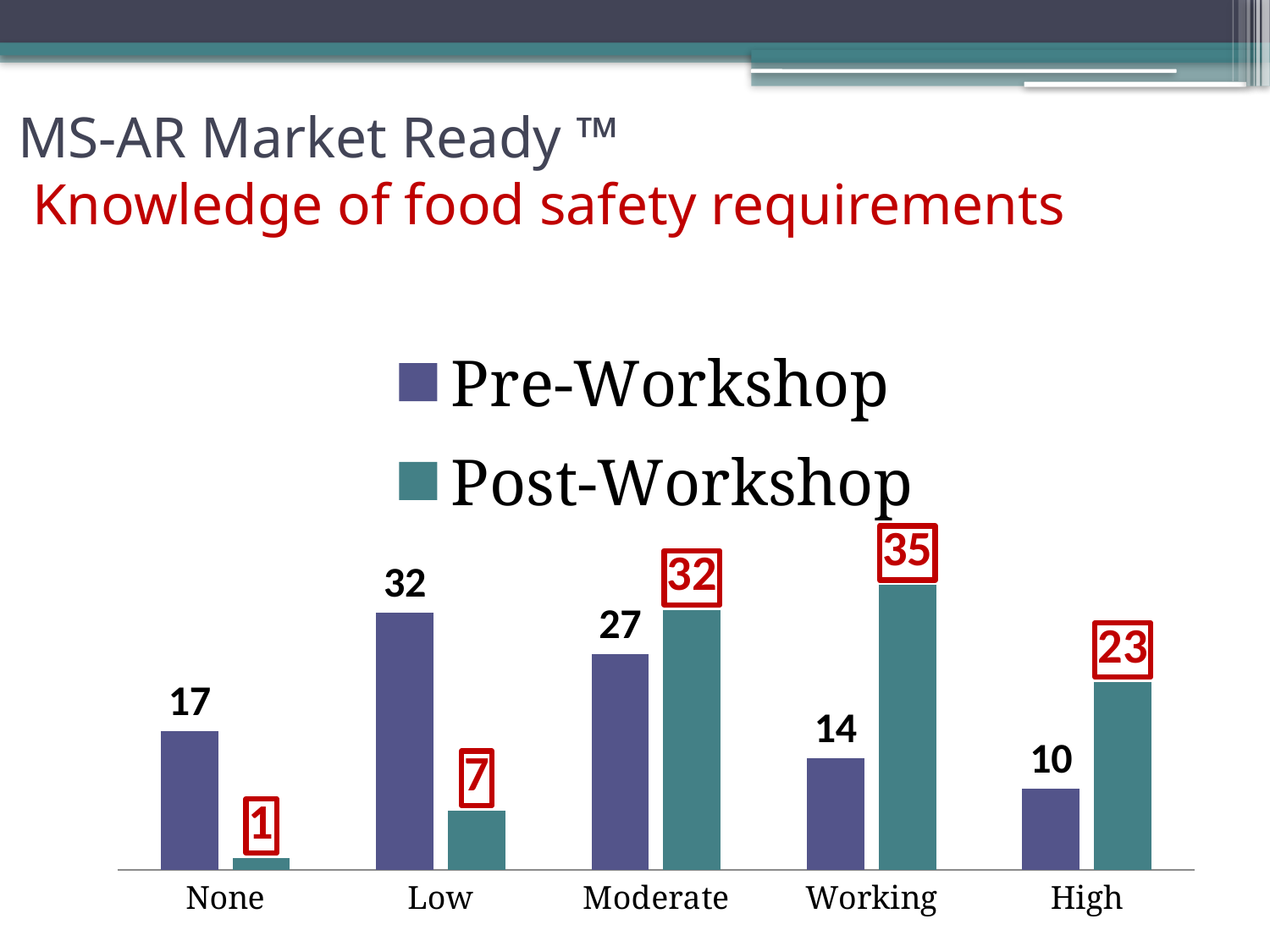
Which category has the lowest Pre-Workshop value? High Which series is shown in teal in the legend? Post-Workshop What is the Post-Workshop value for the None category? 1 What is the Post-Workshop value for the Working category? 35 How many series does the legend list? 2 What kind of chart is shown on the slide? Bar chart What is the Pre-Workshop value for the Low category? 32 Which is larger for the Moderate category, the Pre-Workshop or the Post-Workshop value? Post-Workshop What is the difference between the Post-Workshop and Pre-Workshop values for the High category? 13 Which category has the highest Post-Workshop value? Working What is the difference between the Pre-Workshop and Post-Workshop values for the Low category? 25 How many categories are shown on the x axis? 5